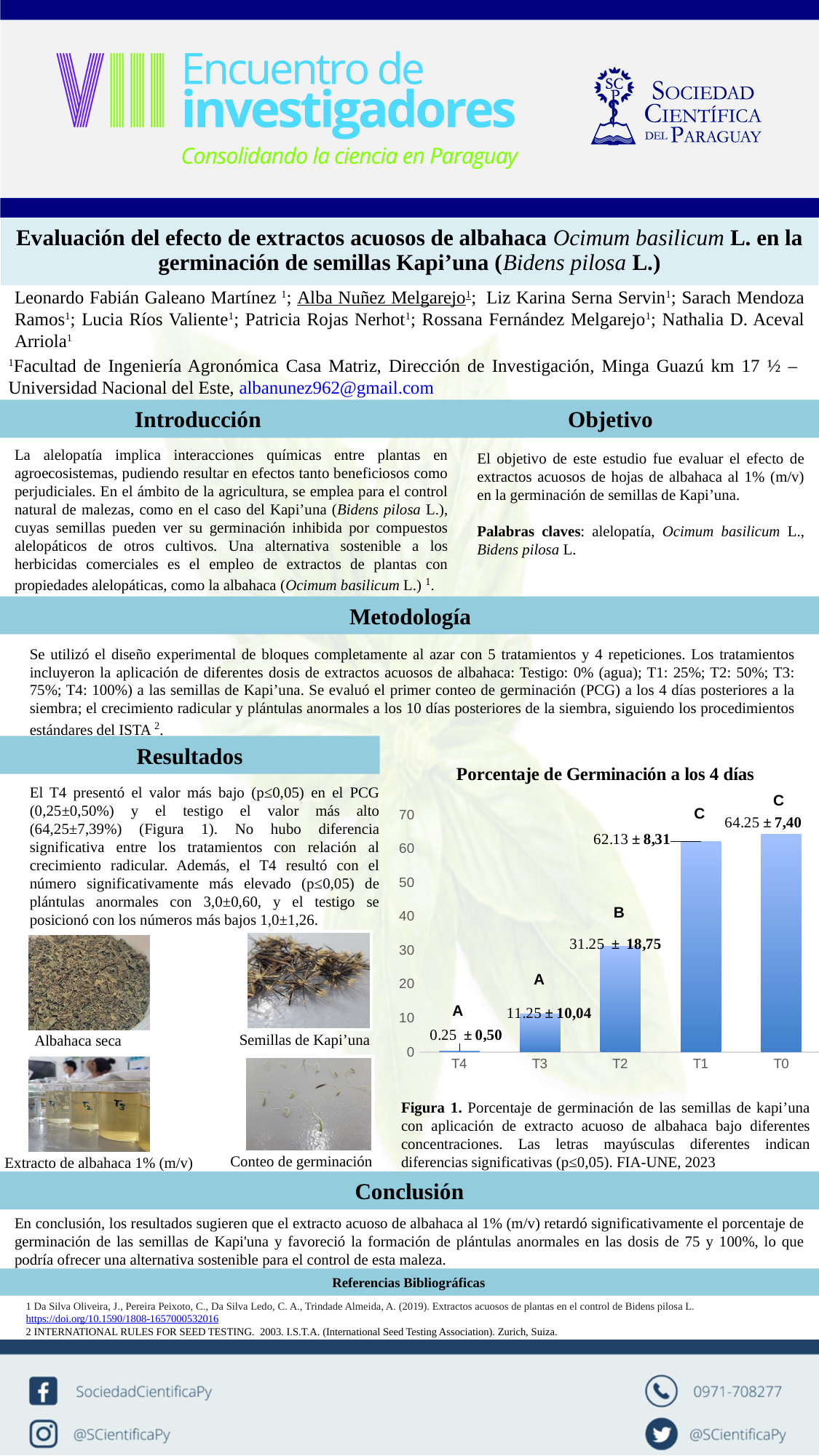
What type of chart is shown under the heading 'Porcentaje de Germinación a los 4 días'? bar chart What mean value is labelled for T1 in the chart? 62.13 What mean germination percentage is labelled for T4 in the chart? 0.25 What is the title of the chart on the slide? Porcentaje de Germinación a los 4 días Do the bar values rise or fall moving along the x axis from T4 to T0? rise Which treatment has the lowest germination percentage in the chart? T4 Which treatment has the highest germination percentage in the chart? T0 How many treatment categories are plotted on the x axis of the chart? 5 Is the value for T3 in the chart greater or less than 20? less What is the difference between the mean values labelled for T2 and T3 in the chart? 20 Which has a larger germination percentage in the chart, T2 or T3? T2 What is the full data label shown above the T3 bar in the chart? 11.25 ± 10,04